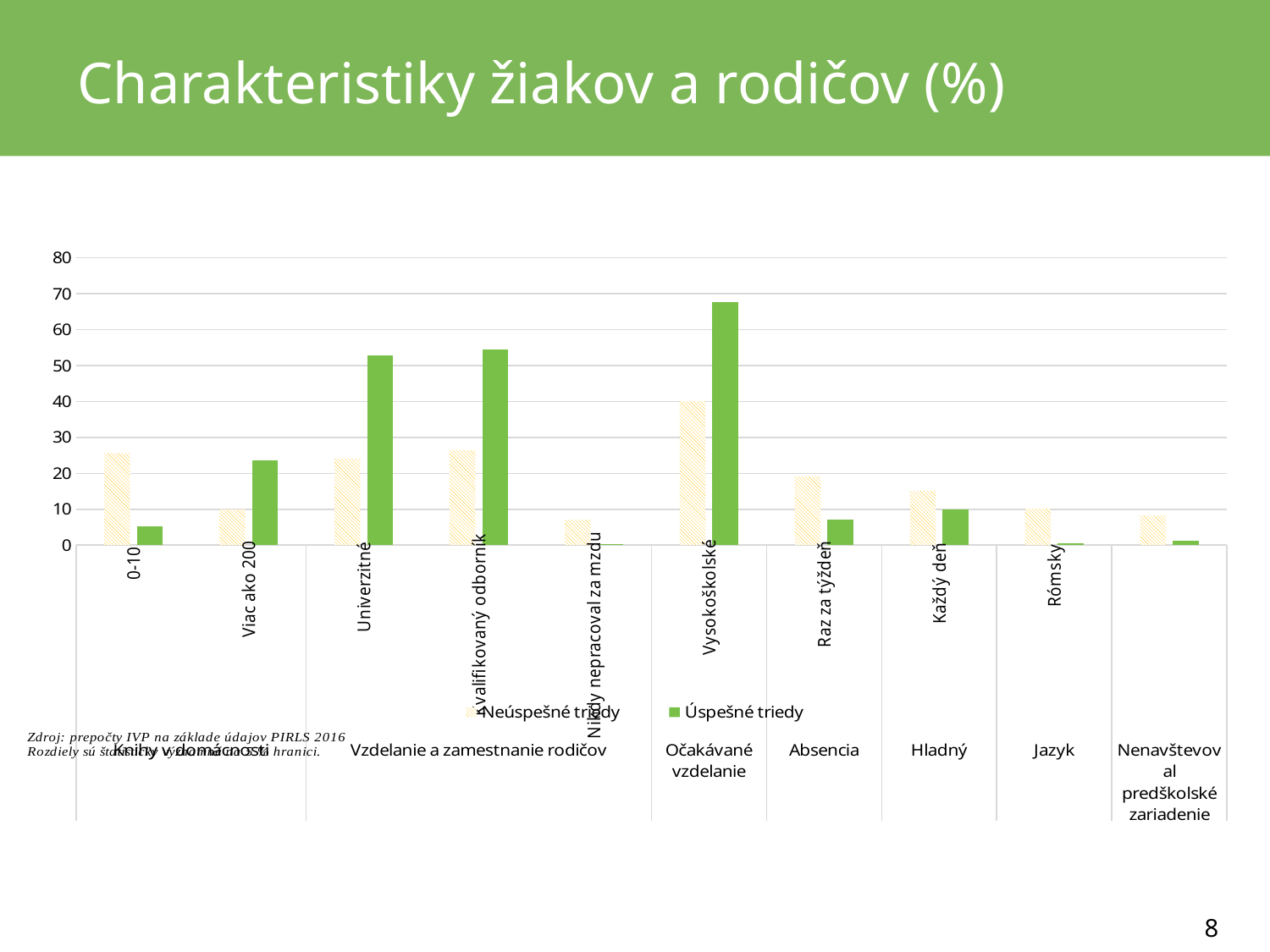
For the category Raz za týždeň, which series has the larger value, Neúspešné triedy or Úspešné triedy? Neúspešné triedy Is the Neúspešné triedy value for 0-10 greater or less than 20? greater Is the Úspešné triedy value for Vysokoškolské greater or less than 60? greater For the category 0-10, which series has the larger value, Neúspešné triedy or Úspešné triedy? Neúspešné triedy Is the Úspešné triedy value for Univerzitné greater or less than 50? greater Which category has the highest value for Úspešné triedy? Vysokoškolské How many series does the legend list? 2 What are the two series named in the legend? Neúspešné triedy and Úspešné triedy What kind of chart is shown on the slide? bar chart Which category has the highest value for Neúspešné triedy? Vysokoškolské For the category Viac ako 200, which series has the larger value, Neúspešné triedy or Úspešné triedy? Úspešné triedy